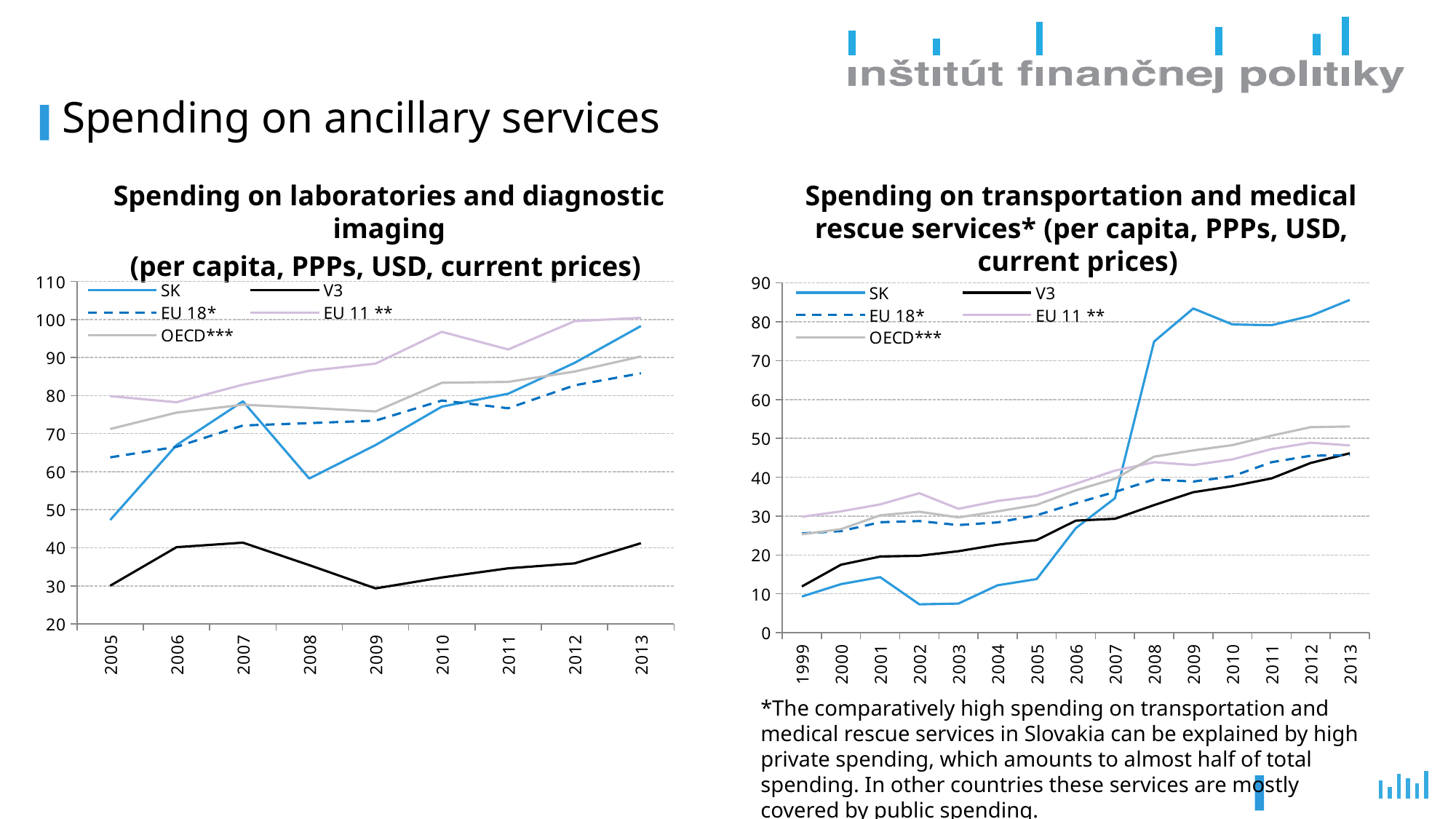
In the 'Spending on transportation and medical rescue services' chart, does the V3 line generally rise or fall from 1999 to 2013? rise In the 'Spending on laboratories and diagnostic imaging' chart, is the value for SK in 2005 greater or less than 50? less In the 'Spending on laboratories and diagnostic imaging' chart, which series is the lowest in 2013? V3 In the 'Spending on transportation and medical rescue services' chart, is the value for SK in 2002 greater or less than 10? less In the 'Spending on laboratories and diagnostic imaging' chart, is the value for SK in 2013 greater or less than 90? greater How many years are shown on the x axis of the 'Spending on transportation and medical rescue services' chart? 15 How many series does the legend of the 'Spending on laboratories and diagnostic imaging' chart list? 5 In the 'Spending on laboratories and diagnostic imaging' chart, which series is the highest in 2010? EU 11 ** What type of chart is the 'Spending on laboratories and diagnostic imaging' chart? line chart How many years are shown on the x axis of the 'Spending on laboratories and diagnostic imaging' chart? 9 In the 'Spending on transportation and medical rescue services' chart, which is larger in 2005, SK or V3? V3